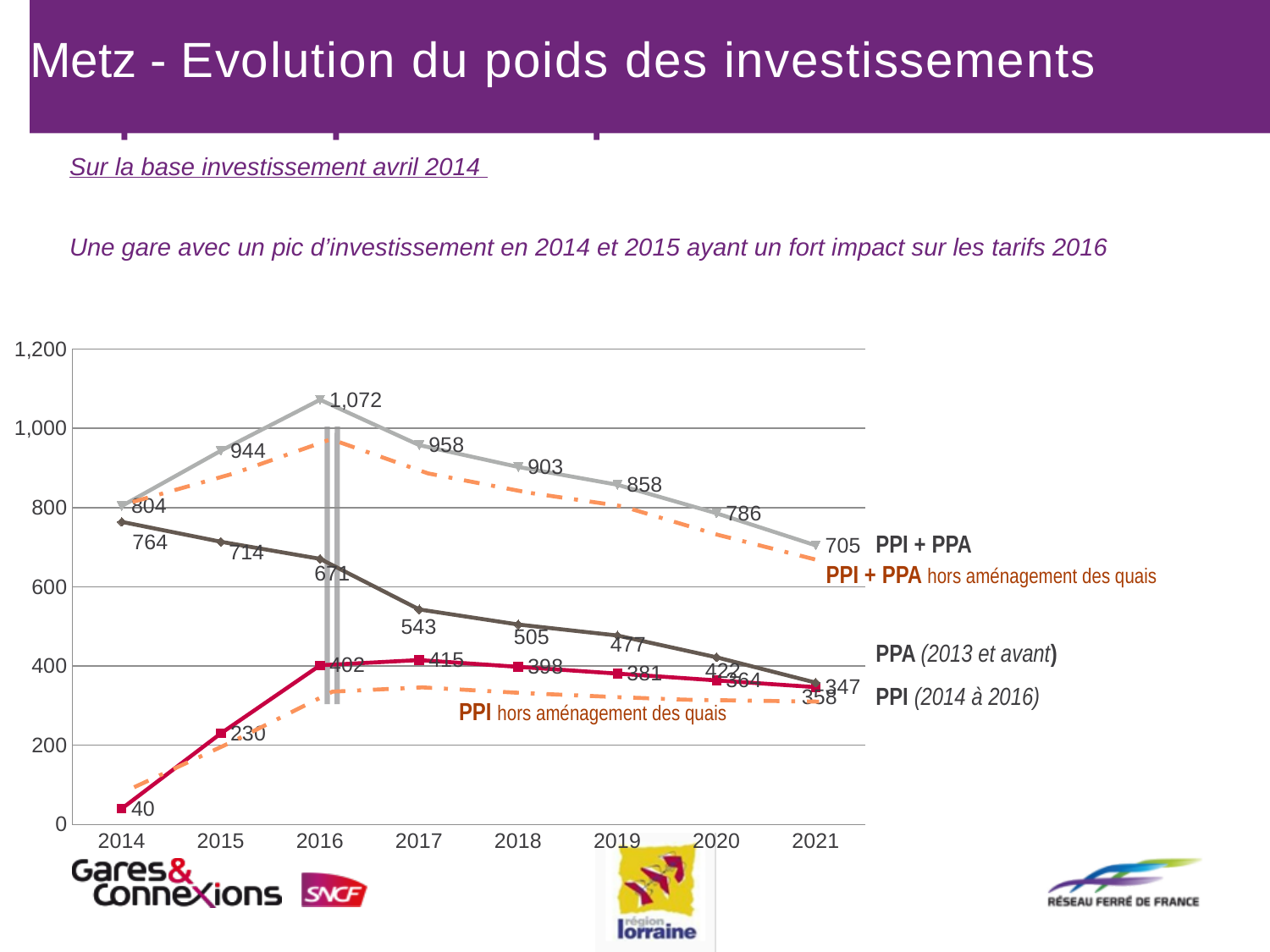
What is the difference between the PPI + PPA values for 2016 and 2015? 128 Does the PPA (2013 et avant) series rise or fall from 2014 to 2021? falls What is the value of PPI (2014 à 2016) in 2014? 40 Is the value of PPI + PPA hors aménagement des quais in 2016 greater or less than 800? greater How many series are labelled on the chart? 5 How many years are shown on the x axis? 8 What is the value of PPI + PPA in 2021? 705 What kind of chart is shown on the slide? line chart In 2017, which is larger: PPA (2013 et avant) or PPI (2014 à 2016)? PPA (2013 et avant) What is the value of PPA (2013 et avant) in 2014? 764 What is the value of PPI + PPA in 2016? 1,072 In which year does PPI + PPA reach its highest value? 2016